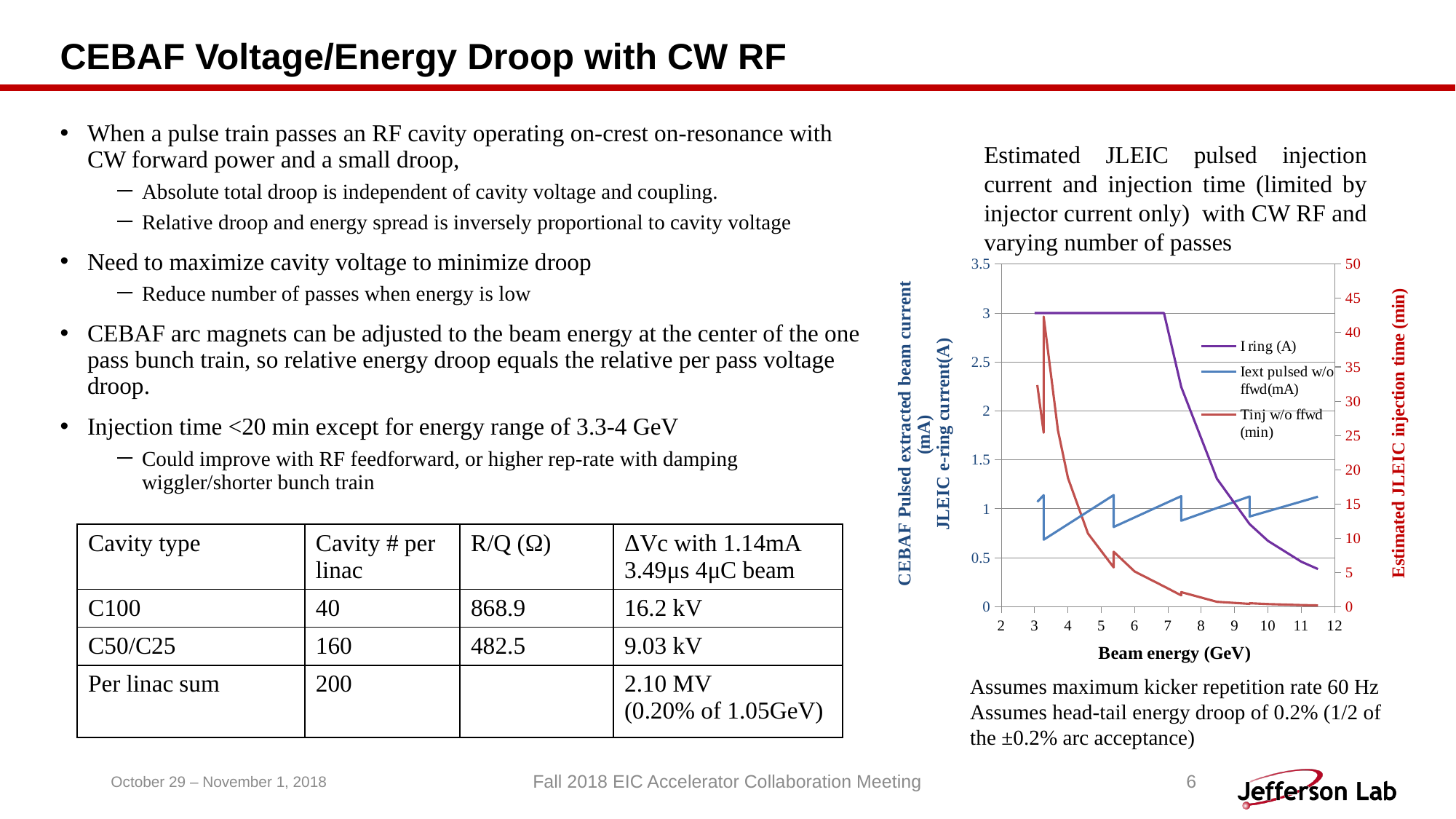
Which series is the highest on the left axis at a beam energy of 5 GeV, I ring (A) or Iext pulsed w/o ffwd(mA)? I ring (A) What is the title of the x axis of the chart? Beam energy (GeV) What kind of chart is shown on the slide? line chart Is the value of Tinj w/o ffwd (min) at a beam energy of 10 GeV greater or less than 5 on the right axis? less What is the title of the right-hand y axis of the chart? Estimated JLEIC injection time (min) Is the value of I ring (A) at a beam energy of 10 GeV greater or less than 1? less How many series does the chart legend list? 3 Is the peak value of Tinj w/o ffwd (min) near 3.3 GeV greater or less than 30 on the right axis? greater Does the Tinj w/o ffwd (min) series generally rise or fall as beam energy increases from 4 GeV to 12 GeV? fall Does the I ring (A) series rise or fall as beam energy increases from 7 GeV to 12 GeV? fall